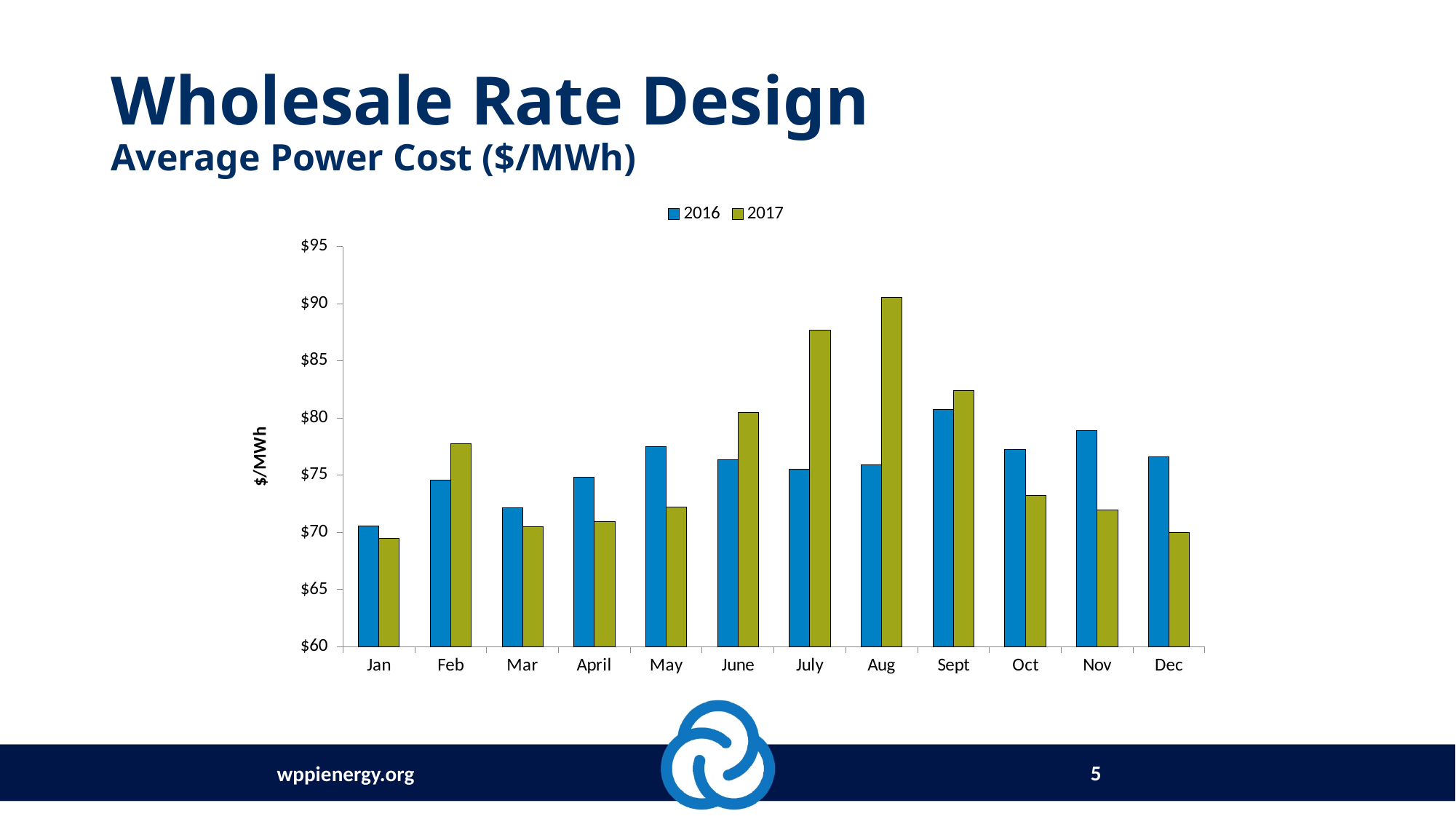
Is the 2017 value for Sept greater or less than $80? greater How many months are shown on the x axis? 12 How many series does the legend list? 2 Is the 2016 value for Nov greater or less than $80? less What kind of chart is shown on the slide? bar chart In which month is the 2016 average power cost lowest? Jan Is the 2017 value for May greater or less than $75? less In which month is the 2016 average power cost highest? Sept In which month is the 2017 average power cost highest? Aug For Nov, which series has the larger value, 2016 or 2017? 2016 For Aug, which series has the larger value, 2016 or 2017? 2017